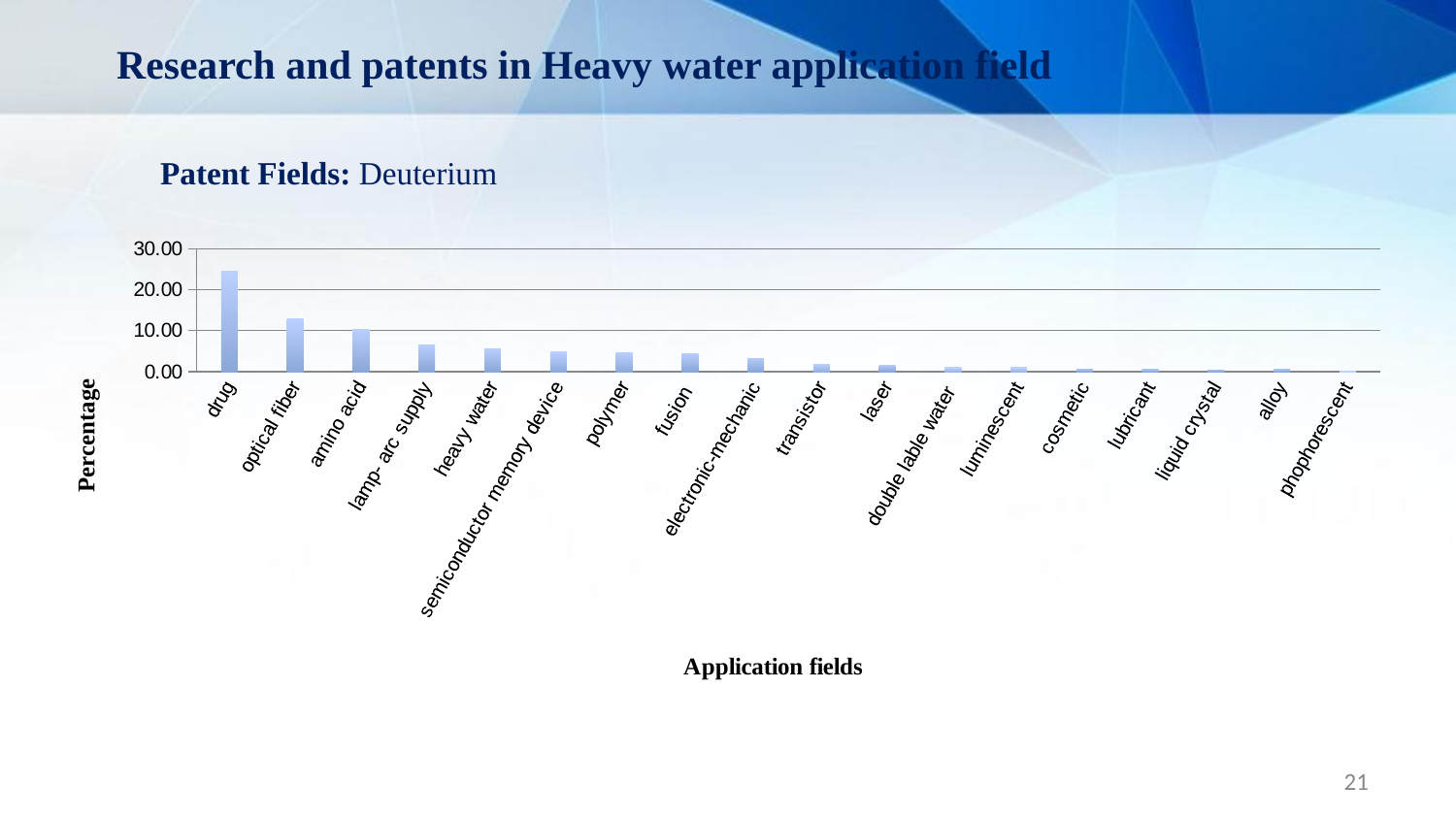
Which has a higher percentage, drug or optical fiber? drug What kind of chart is shown on the slide? bar chart Is the value for drug greater or less than 30.00? less What is the label of the vertical axis? Percentage Which has a higher percentage, heavy water or transistor? heavy water Is the value for lamp- arc supply greater or less than 10.00? less How many application fields are plotted on the x axis? 18 Which application field has the highest percentage? drug Do the values rise or fall moving from left to right along the x axis? fall Is the value for optical fiber greater or less than 10.00? greater Which has a higher percentage, optical fiber or amino acid? optical fiber